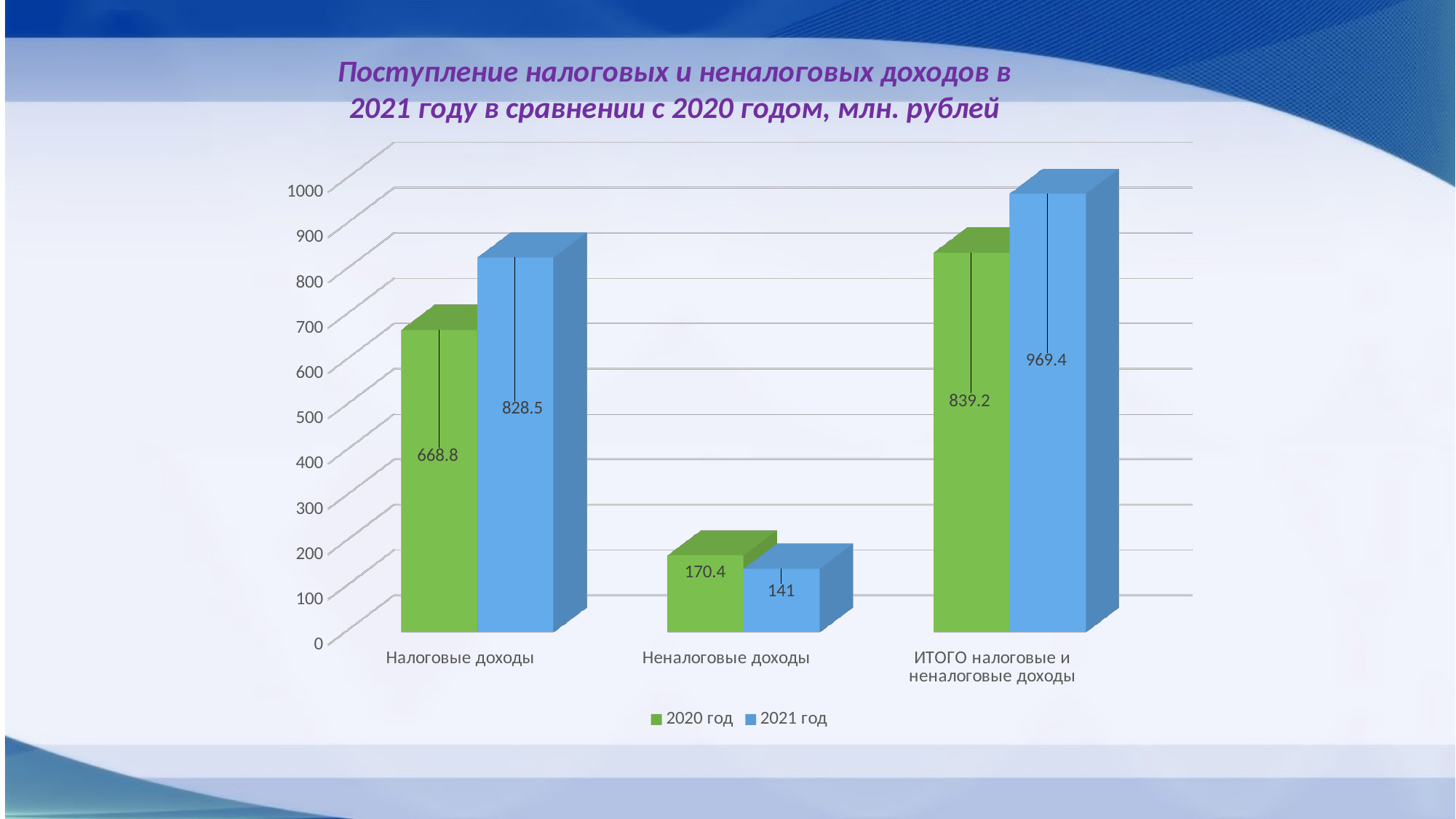
Which category has the lowest value in the 2020 год series? Неналоговые доходы What is the value for Налоговые доходы in the 2020 год series? 668.8 What kind of chart is shown on the slide? Bar chart Which category has the highest value in the 2021 год series? ИТОГО налоговые и неналоговые доходы Which is larger for Неналоговые доходы: the 2020 год value or the 2021 год value? 2020 год How many series does the legend list? 2 What is the difference between the 2021 год and 2020 год values for Налоговые доходы? 159.7 Which colour represents the 2021 год series? Blue What is the value for ИТОГО налоговые и неналоговые доходы in the 2020 год series? 839.2 How many categories are shown on the x axis? 3 What is the value for Неналоговые доходы in the 2021 год series? 141 What is the value for Налоговые доходы in the 2021 год series? 828.5